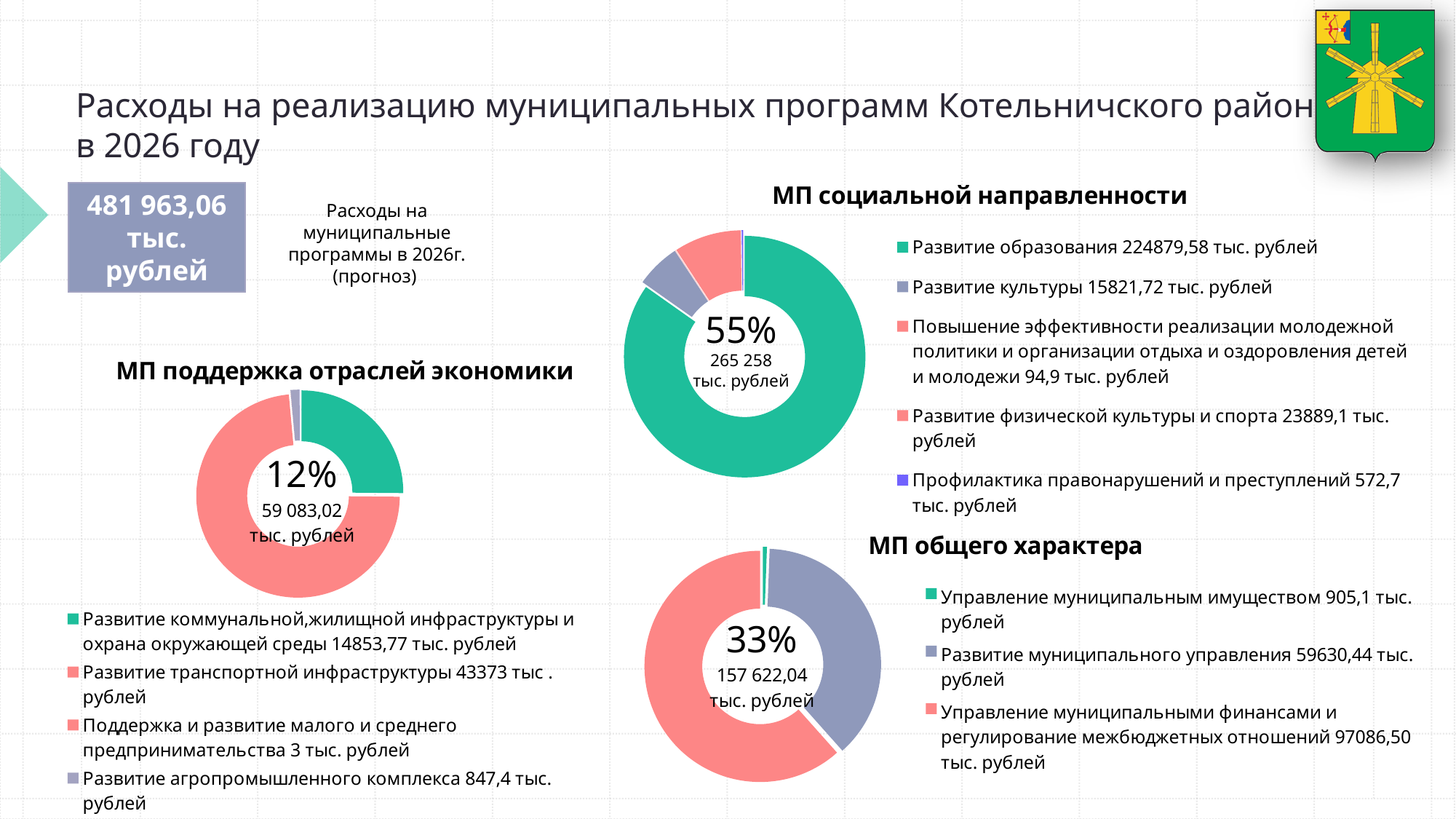
In the "МП социальной направленности" chart, what is the value for "Развитие образования"? 224879,58 тыс. рублей In the "МП социальной направленности" chart, which is larger: "Развитие культуры" or "Развитие физической культуры и спорта"? Развитие физической культуры и спорта In the "МП общего характера" chart, what is the difference between "Управление муниципальными финансами и регулирование межбюджетных отношений" and "Развитие муниципального управления"? 37456,06 тыс. рублей What percentage is shown in the centre of the "МП общего характера" chart? 33% In the "МП общего характера" chart, what is the value for "Развитие муниципального управления"? 59630,44 тыс. рублей In the "МП общего характера" chart, which category has the largest value? Управление муниципальными финансами и регулирование межбюджетных отношений How many categories does the legend of the "МП социальной направленности" chart list? 5 What type of chart is used for "МП поддержка отраслей экономики"? Pie (donut) chart In the "МП поддержка отраслей экономики" chart, which category has the smallest value? Поддержка и развитие малого и среднего предпринимательства In the "МП поддержка отраслей экономики" chart, what is the value for "Развитие транспортной инфраструктуры"? 43373 тыс. рублей In the "МП социальной направленности" chart, which category has the largest value? Развитие образования How many categories does the legend of the "МП общего характера" chart list? 3